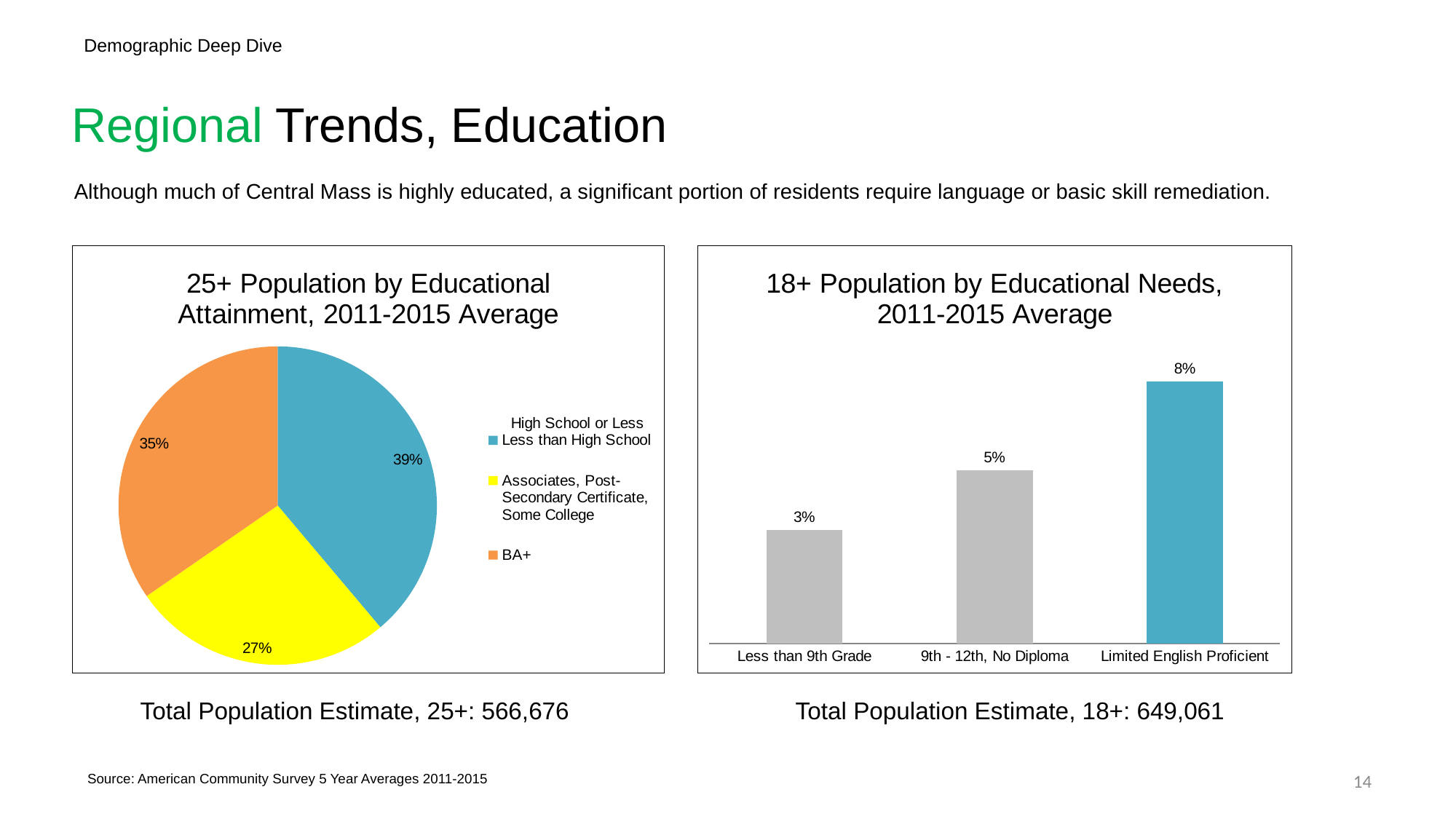
In the pie chart titled "25+ Population by Educational Attainment, 2011-2015 Average", what share of the population falls in the "Associates, Post-Secondary Certificate, Some College" category? 27% In the pie chart on the left, what is the difference in percentage points between the BA+ slice and the Associates, Post-Secondary Certificate, Some College slice? 8 percentage points In the chart titled "18+ Population by Educational Needs, 2011-2015 Average", what is the value for Limited English Proficient? 8% In the chart on the right, do the values rise or fall from left to right across the categories? Rise In the pie chart on the left, how many slices are there? 3 What type of chart is the chart on the right of the slide? Bar chart In the pie chart titled "25+ Population by Educational Attainment, 2011-2015 Average", what share of the population has a BA+? 35% In the chart titled "18+ Population by Educational Needs, 2011-2015 Average", which category has the highest value? Limited English Proficient In the chart titled "18+ Population by Educational Needs, 2011-2015 Average", what is the difference between the values for Limited English Proficient and 9th - 12th, No Diploma? 3 percentage points In the chart titled "18+ Population by Educational Needs, 2011-2015 Average", what is the value for Less than 9th Grade? 3% In the pie chart on the left, which category has the smallest slice? Associates, Post-Secondary Certificate, Some College What type of chart is the chart on the left of the slide? Pie chart